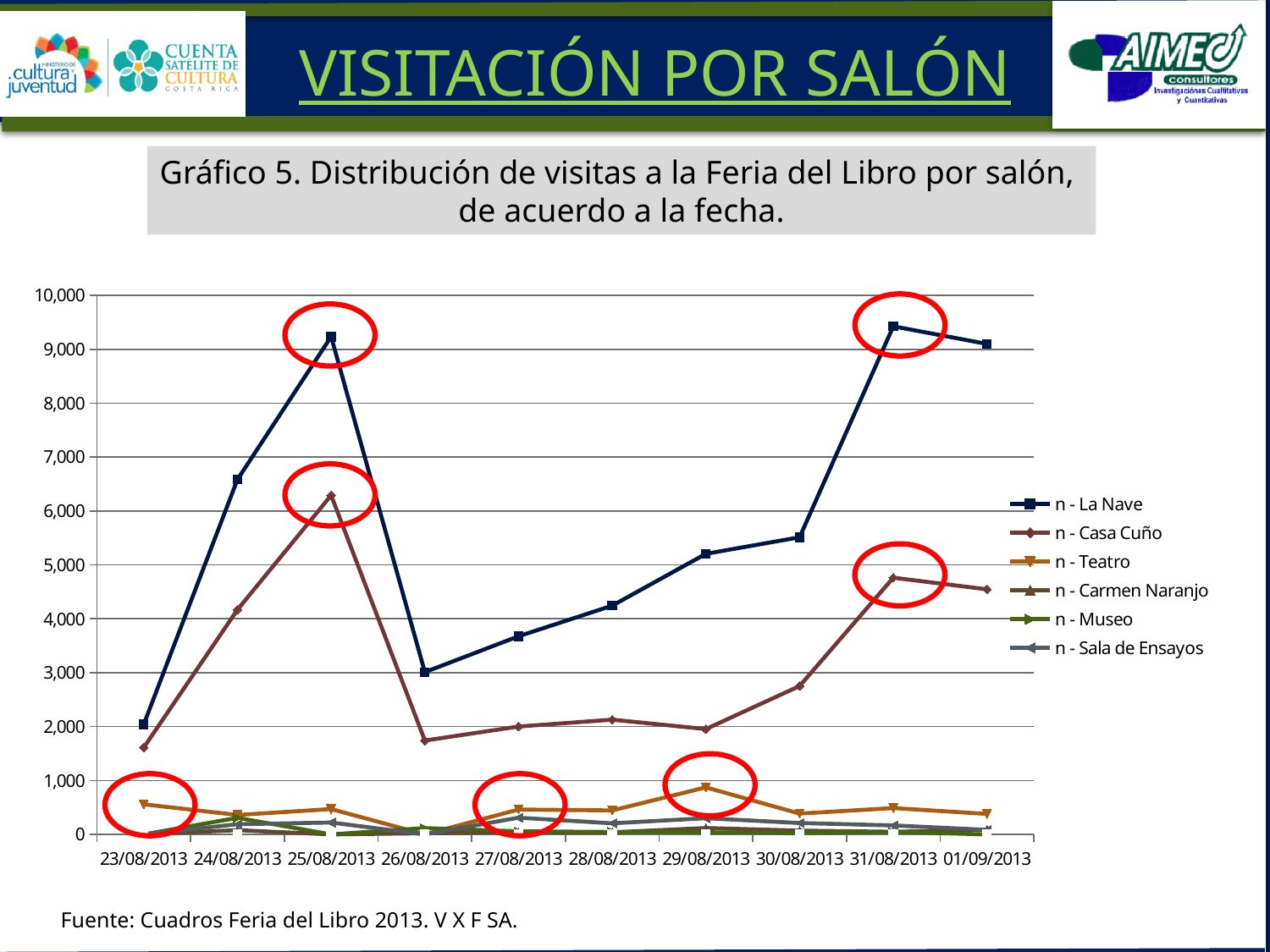
Is the value for n - Teatro on 29/08/2013 greater or less than 1,000? less Does the n - La Nave series rise or fall between 26/08/2013 and 31/08/2013? rise Is the value for n - Casa Cuño on 23/08/2013 greater or less than 2,000? less On which date does the n - Casa Cuño series reach its highest value? 25/08/2013 How many dates are plotted along the x axis? 10 On 28/08/2013, which series has the larger value, n - La Nave or n - Casa Cuño? n - La Nave What is the title of the chart shown on the slide? Gráfico 5. Distribución de visitas a la Feria del Libro por salón, de acuerdo a la fecha. How many series does the legend list? 6 Is the value for n - La Nave on 24/08/2013 greater or less than 6,000? greater What kind of chart is shown on the slide? line chart On which date does the n - La Nave series have its lowest value? 23/08/2013